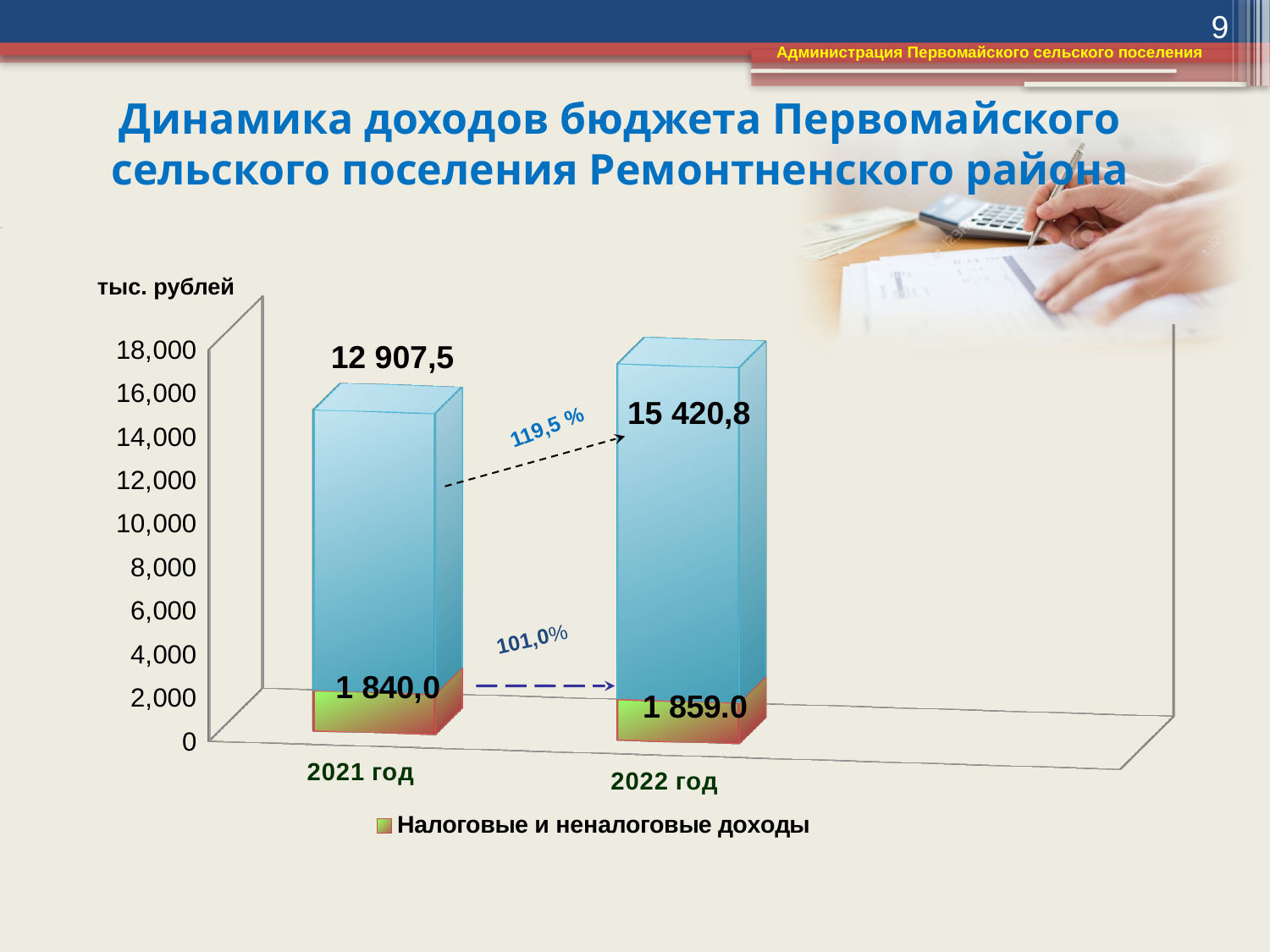
How many years (categories) are shown on the x axis? 2 What is the difference between the Налоговые и неналоговые доходы values for 2022 год and 2021 год? 19,0 What value is labelled on the upper (blue) segment of the 2022 год bar? 15 420,8 Do the bar heights rise or fall from 2021 год to 2022 год? rise What is the value of Налоговые и неналоговые доходы for 2021 год? 1 840,0 What kind of chart is shown on the slide? bar chart What is the value of Налоговые и неналоговые доходы for 2022 год? 1 859.0 What is the difference between the upper (blue) segment values for 2022 год and 2021 год? 2 513,3 What value is labelled on the upper (blue) segment of the 2021 год bar? 12 907,5 How many series does the legend list? 1 Which year has the larger value labelled on the upper (blue) segment, 2021 год or 2022 год? 2022 год What percentage is written on the upper dashed arrow between the two bars? 119,5 %